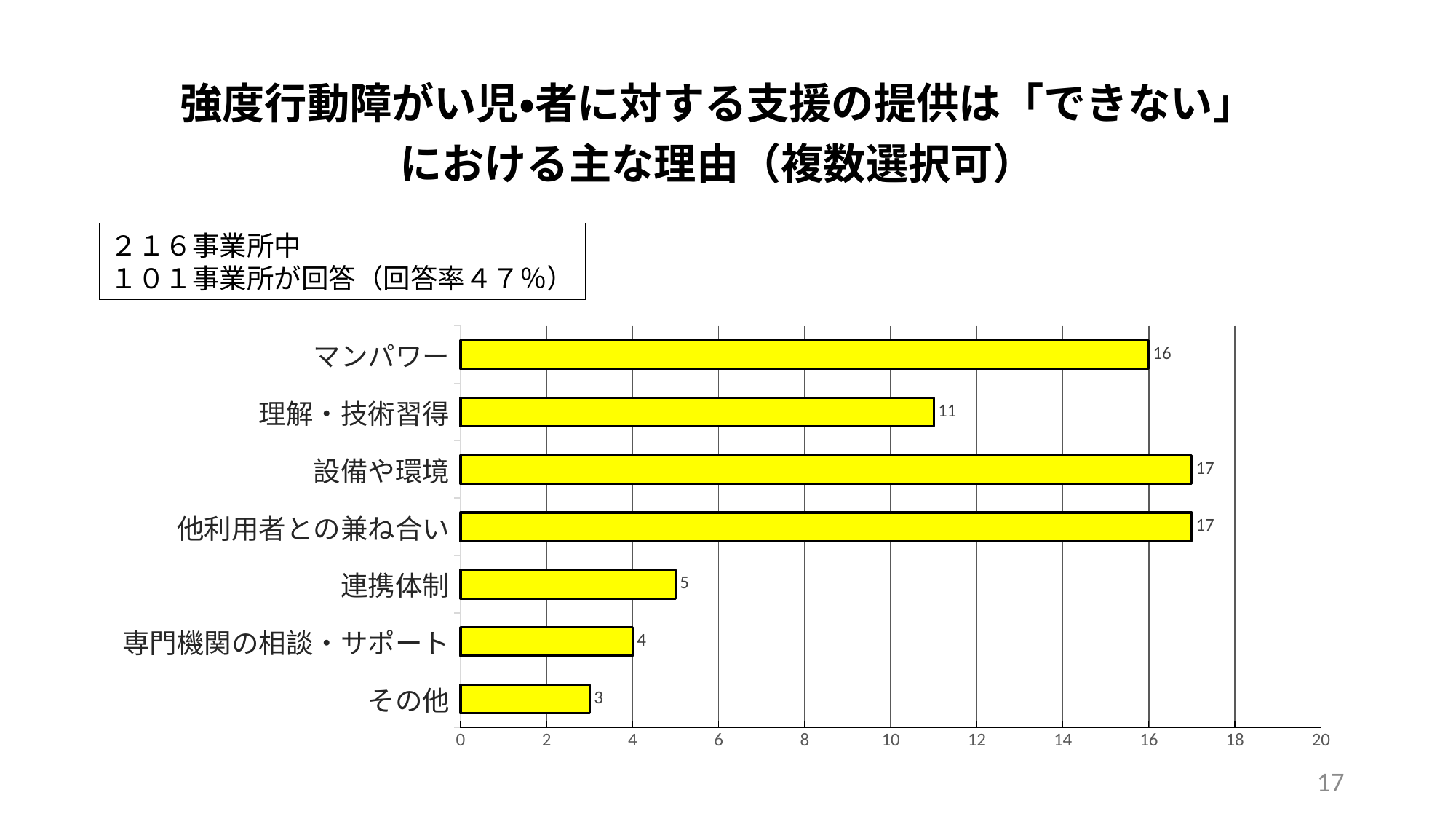
Which category has the lowest value? その他 Is the value for 他利用者との兼ね合い greater or less than 10? greater How many categories are shown in the chart? 7 What is the value for マンパワー? 16 What colour are the bars in the chart? yellow What is the difference between the values for マンパワー and その他? 13 What is the difference between the values for 設備や環境 and 理解・技術習得? 6 What is the value for 専門機関の相談・サポート? 4 What kind of chart is shown on the slide? bar chart Which is larger, the value for マンパワー or the value for 理解・技術習得? マンパワー What is the value for 理解・技術習得? 11 What is the value for 連携体制? 5